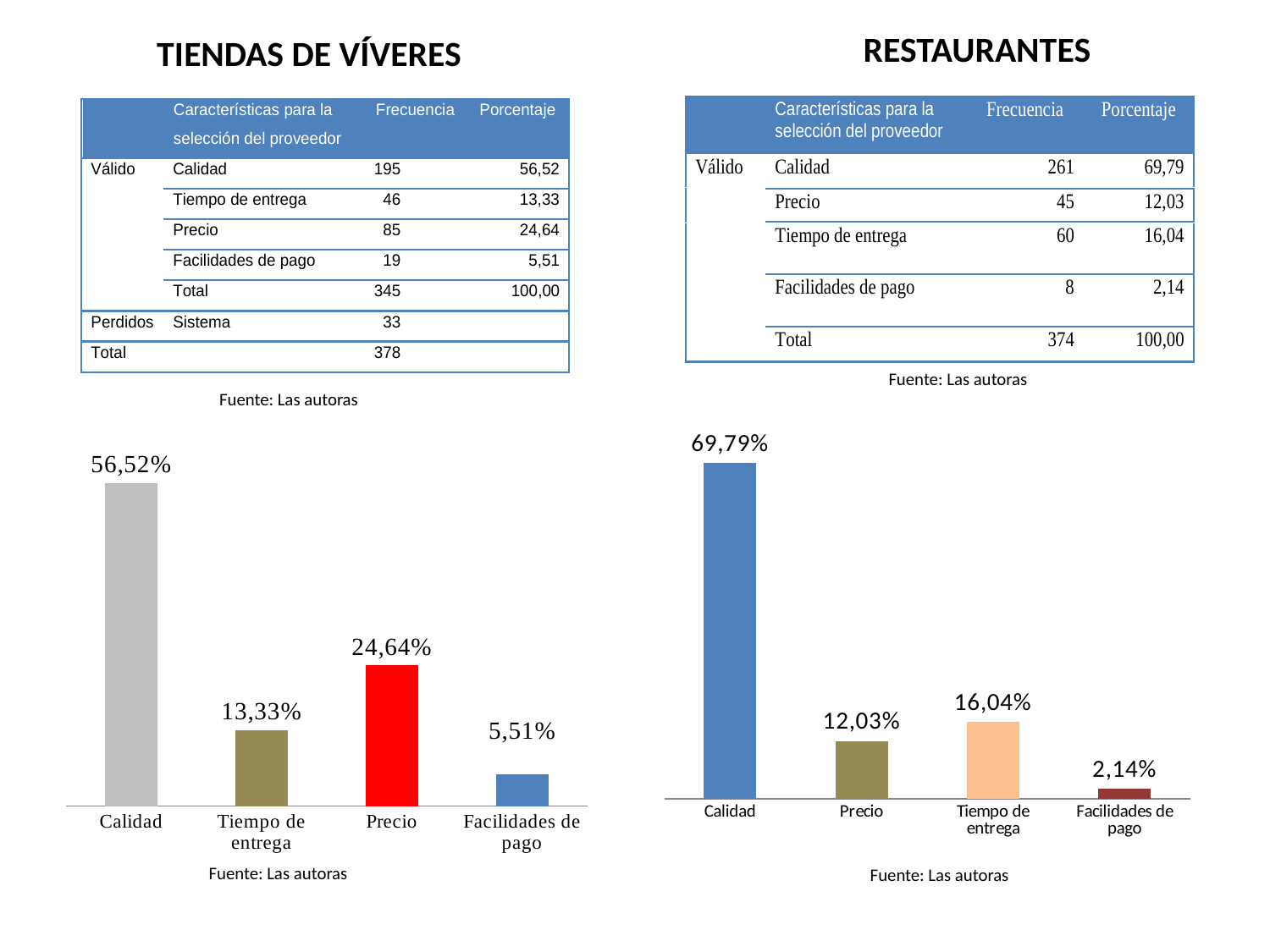
In the Restaurantes chart, what is the difference between Calidad and Tiempo de entrega? 53,75% How many categories are shown in the Restaurantes chart? 4 In the Tiendas de Víveres chart, what is the difference between Precio and Tiempo de entrega? 11,31% In the Restaurantes chart, what is the value for Precio? 12,03% In the Tiendas de Víveres chart, what is the value for Calidad? 56,52% What type of chart is the Tiendas de Víveres chart? Bar chart In the Restaurantes chart, which is larger, Precio or Tiempo de entrega? Tiempo de entrega In the Tiendas de Víveres chart, what is the value for Facilidades de pago? 5,51% In the Restaurantes chart, what is the value for Tiempo de entrega? 16,04% In the Restaurantes chart, which category has the lowest value? Facilidades de pago In the Tiendas de Víveres chart, which category has the highest value? Calidad In the Tiendas de Víveres chart, which is larger, Tiempo de entrega or Precio? Precio